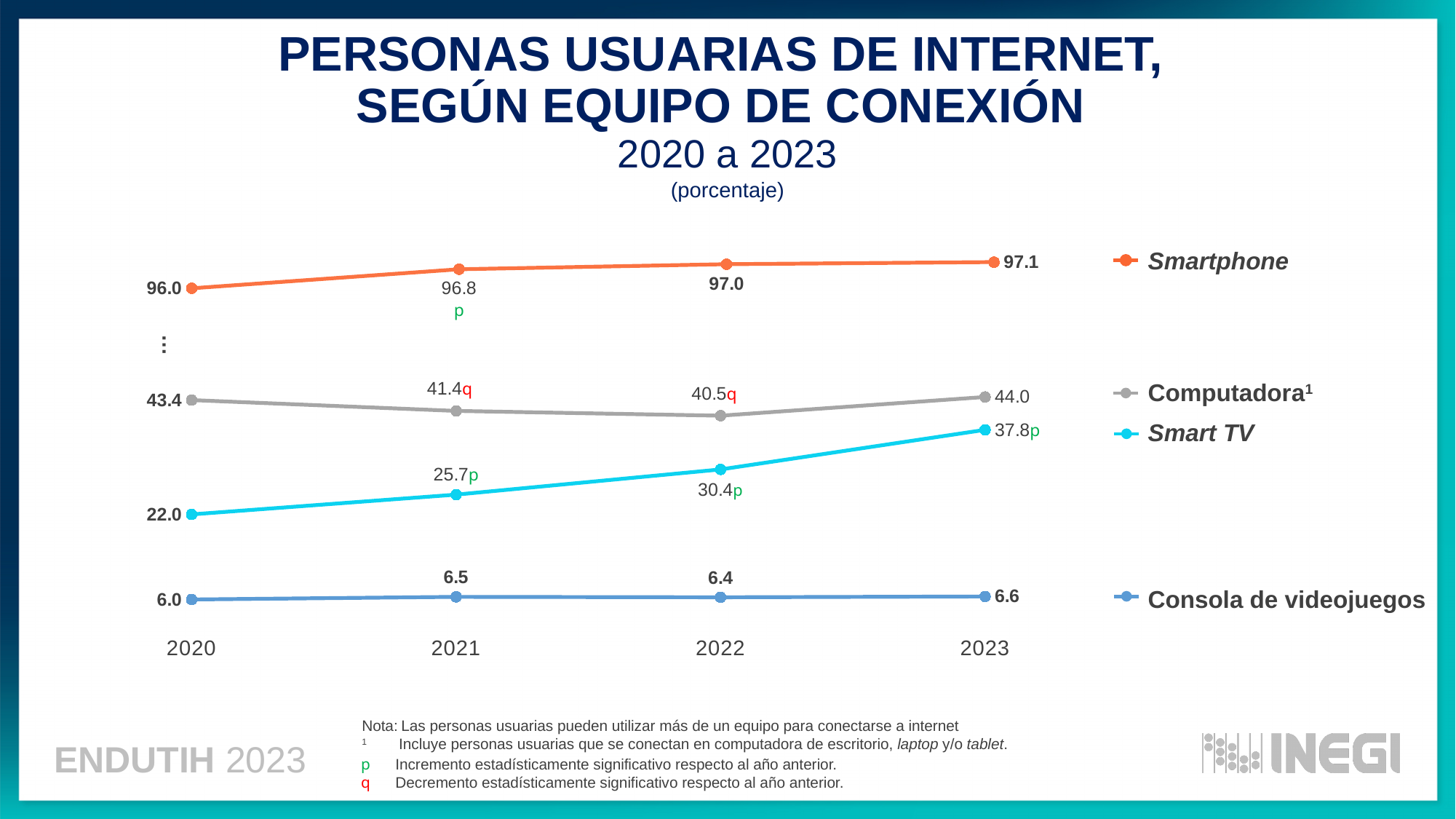
What is the value for Smartphone in 2023? 97.1 What is the value for Consola de videojuegos in 2021? 6.5 How many series does the legend list? 4 What is the value for Smart TV in 2020? 22.0 What type of chart is shown on the slide? line chart Which series has the highest value in 2023? Smartphone What is the value for Computadora in 2022? 40.5 How many years are shown on the x axis? 4 Which is larger, the Computadora value in 2023 or the Smart TV value in 2023? Computadora Which series has the lowest value in 2020? Consola de videojuegos Does the Smart TV series rise or fall from 2020 to 2023? rise What is the difference between the Smart TV values in 2023 and 2020? 15.8